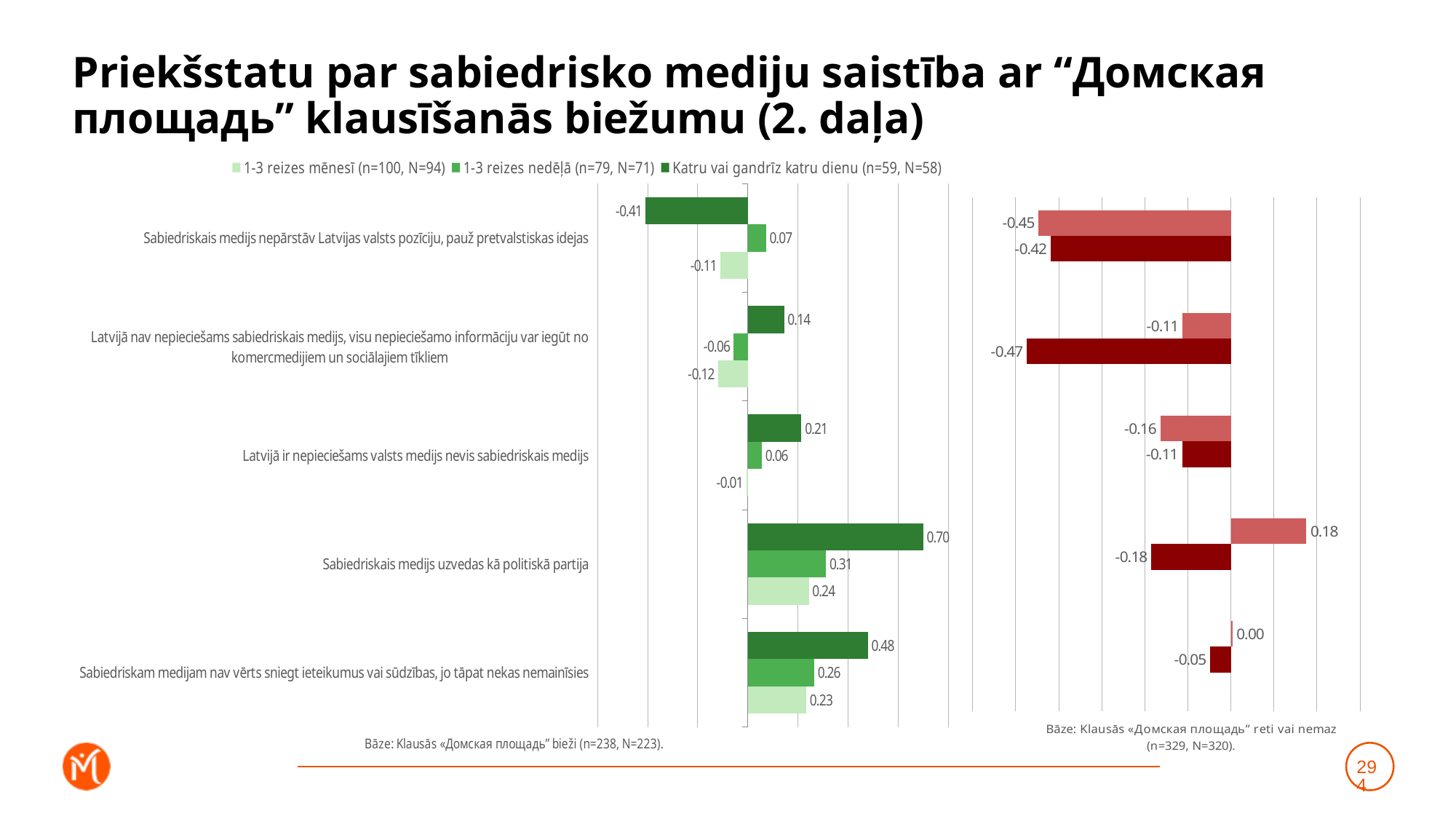
In the left (green) chart, what is the value for 'Katru vai gandrīz katru dienu' for 'Sabiedriskais medijs uzvedas kā politiskā partija'? 0.70 In the left (green) chart, which category has the lowest value for 'Katru vai gandrīz katru dienu'? Sabiedriskais medijs nepārstāv Latvijas valsts pozīciju, pauž pretvalstiskas idejas In the left (green) chart, what is the value for '1-3 reizes mēnesī' for 'Sabiedriskais medijs nepārstāv Latvijas valsts pozīciju, pauž pretvalstiskas idejas'? -0.11 How many series does the legend of the left (green) chart list? 3 In the left (green) chart, which category has the highest value for 'Katru vai gandrīz katru dienu'? Sabiedriskais medijs uzvedas kā politiskā partija What type of chart is the left (green) chart? Bar chart How many categories are shown in the left (green) chart? 5 In the left (green) chart, what is the value for '1-3 reizes nedēļā' for 'Sabiedriskam medijam nav vērts sniegt ieteikumus vai sūdzības, jo tāpat nekas nemainīsies'? 0.26 In the right (red) chart, what is the value of the lighter red bar for 'Sabiedriskais medijs uzvedas kā politiskā partija'? 0.18 In the left (green) chart, what is the difference between the 'Katru vai gandrīz katru dienu' and '1-3 reizes nedēļā' values for 'Sabiedriskais medijs uzvedas kā politiskā partija'? 0.39 In the left (green) chart, for 'Latvijā ir nepieciešams valsts medijs nevis sabiedriskais medijs', which is larger: the 'Katru vai gandrīz katru dienu' value or the '1-3 reizes nedēļā' value? Katru vai gandrīz katru dienu In the right (red) chart, what is the value of the darker red bar for 'Latvijā nav nepieciešams sabiedriskais medijs, visu nepieciešamo informāciju var iegūt no komercmedijiem un sociālajiem tīkliem'? -0.47